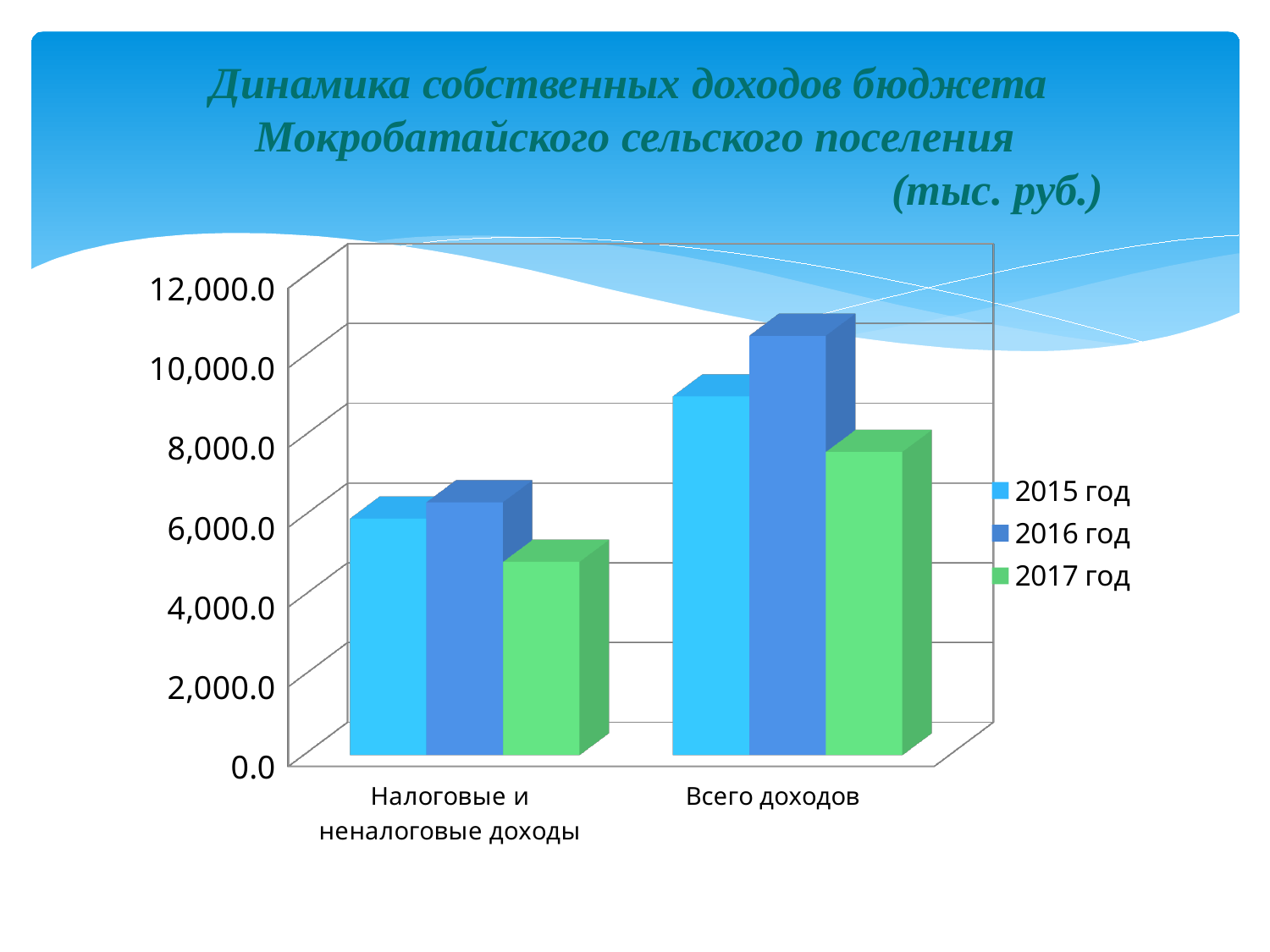
Is the value for 2015 год in the category Всего доходов greater or less than 8,000.0? greater How many categories are shown on the x axis? 2 Which years are listed in the legend? 2015 год, 2016 год, 2017 год In what units are the values given according to the slide title? тыс. руб. Is the value for 2017 год in the category Налоговые и неналоговые доходы greater or less than 6,000.0? less For the category Всего доходов, which year has the highest value? 2016 год How many series does the legend list? 3 In the category Всего доходов, which is larger: the value for 2015 год or for 2017 год? 2015 год For the category Всего доходов, which year has the lowest value? 2017 год Is the value for 2016 год in the category Всего доходов greater or less than 10,000.0? greater For the category Налоговые и неналоговые доходы, which year has the lowest value? 2017 год What kind of chart is shown on the slide? bar chart